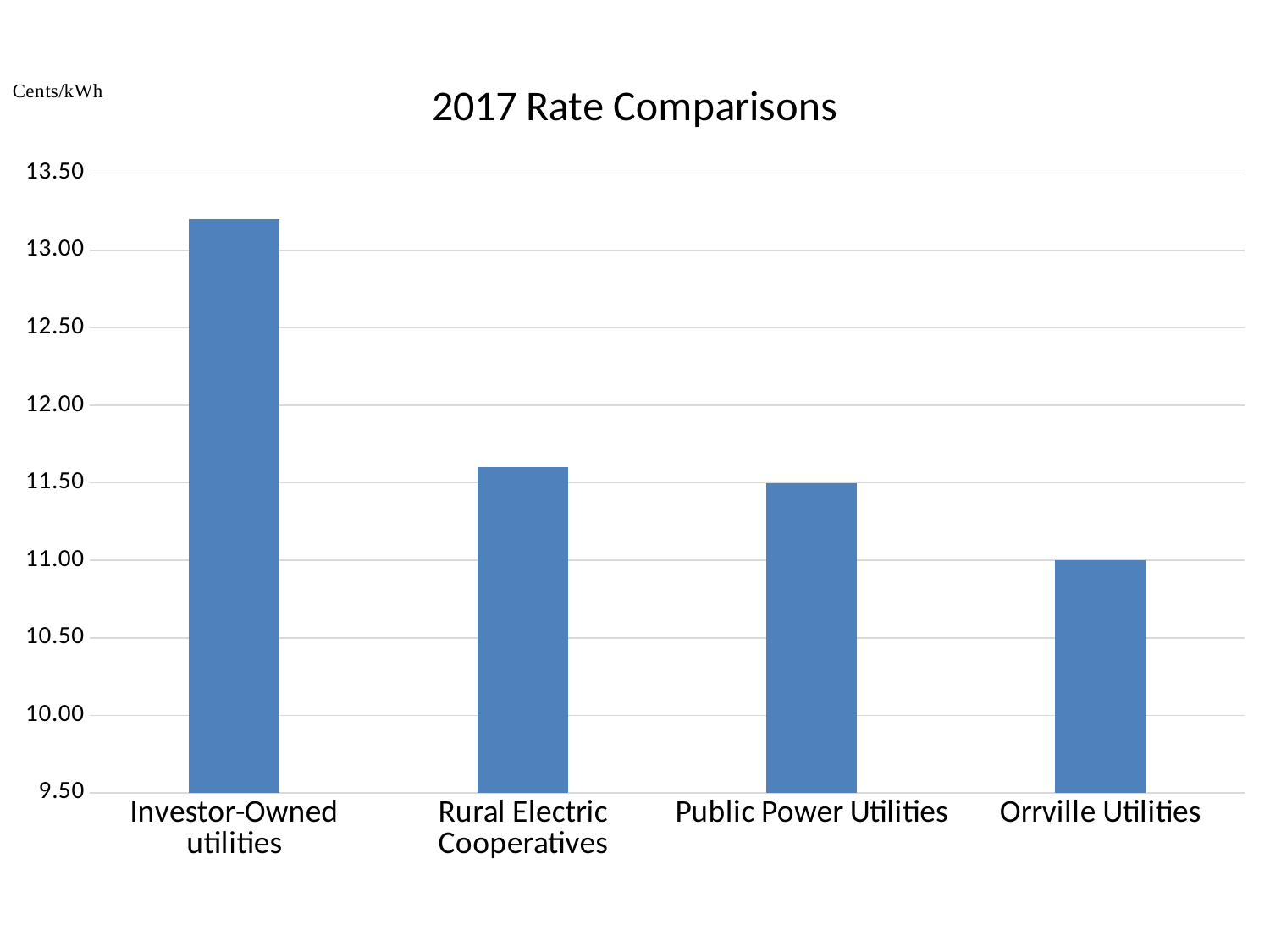
Is the value for Rural Electric Cooperatives greater or less than 12.00? less Which category has the highest rate? Investor-Owned utilities How many categories are plotted on the chart? 4 Which is larger, the value for Investor-Owned utilities or the value for Rural Electric Cooperatives? Investor-Owned utilities Is the value for Investor-Owned utilities greater or less than 13.00? greater Do the values rise or fall moving from left to right across the categories? fall What unit is shown for the values on the chart? Cents/kWh What is the value for Public Power Utilities? 11.50 What is the value for Orrville Utilities? 11.00 What kind of chart is shown on the slide? bar chart Which category has the lowest rate? Orrville Utilities What is the title of the chart? 2017 Rate Comparisons